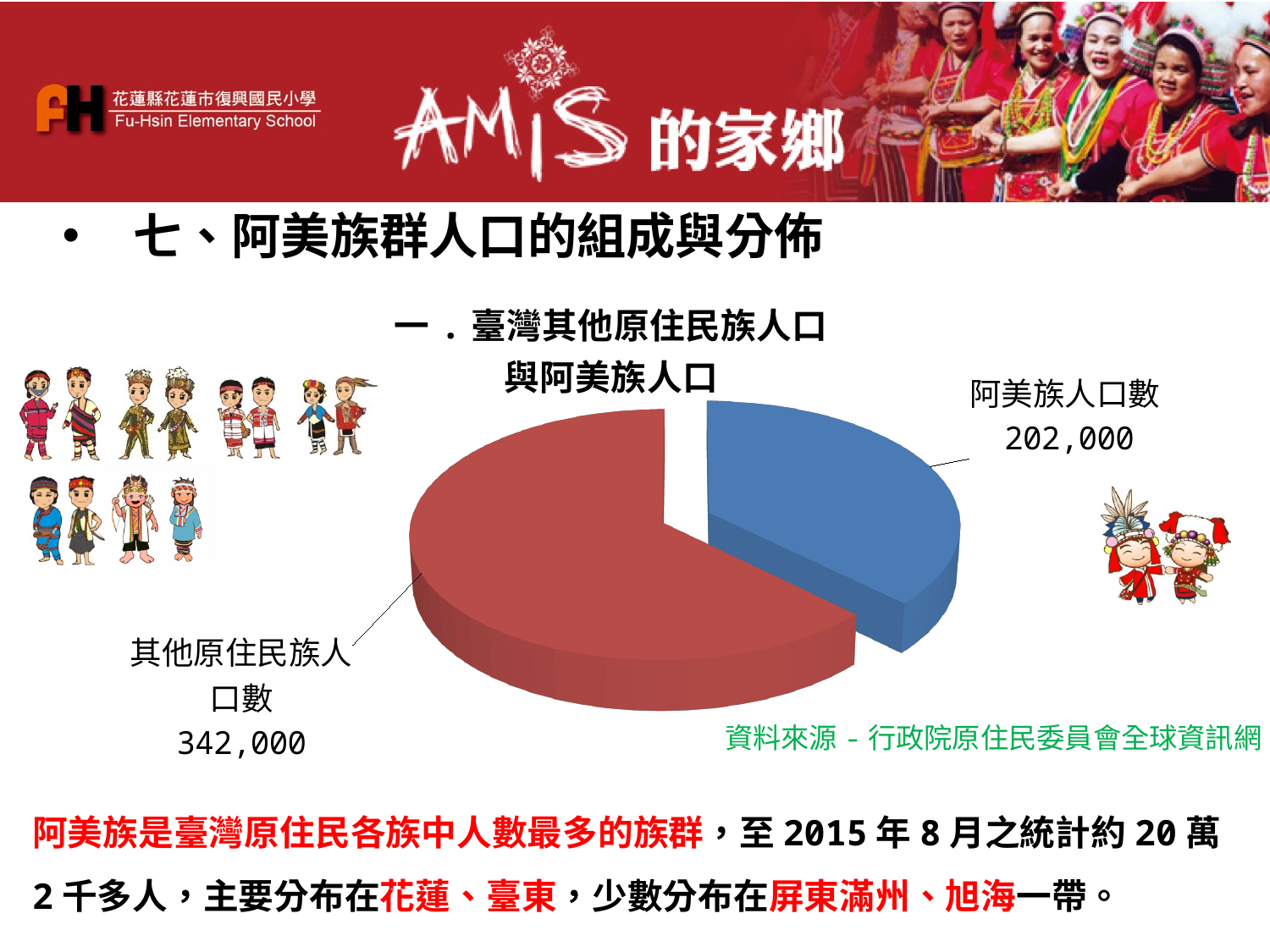
How many slices does the pie chart have? 2 Which is larger, 阿美族人口數 or 其他原住民族人口數? 其他原住民族人口數 Which slice of the pie chart is the smallest? 阿美族人口數 What is the difference between 其他原住民族人口數 and 阿美族人口數? 140,000 What is the total of the two values shown in the pie chart? 544,000 What colour is the 阿美族人口數 slice in the pie chart? blue What is the value for 其他原住民族人口數 in the pie chart? 342,000 What is the title of the pie chart? 一．臺灣其他原住民族人口與阿美族人口 Which slice of the pie chart is the largest? 其他原住民族人口數 What type of chart is shown on the slide? pie chart What is the value for 阿美族人口數 in the pie chart? 202,000